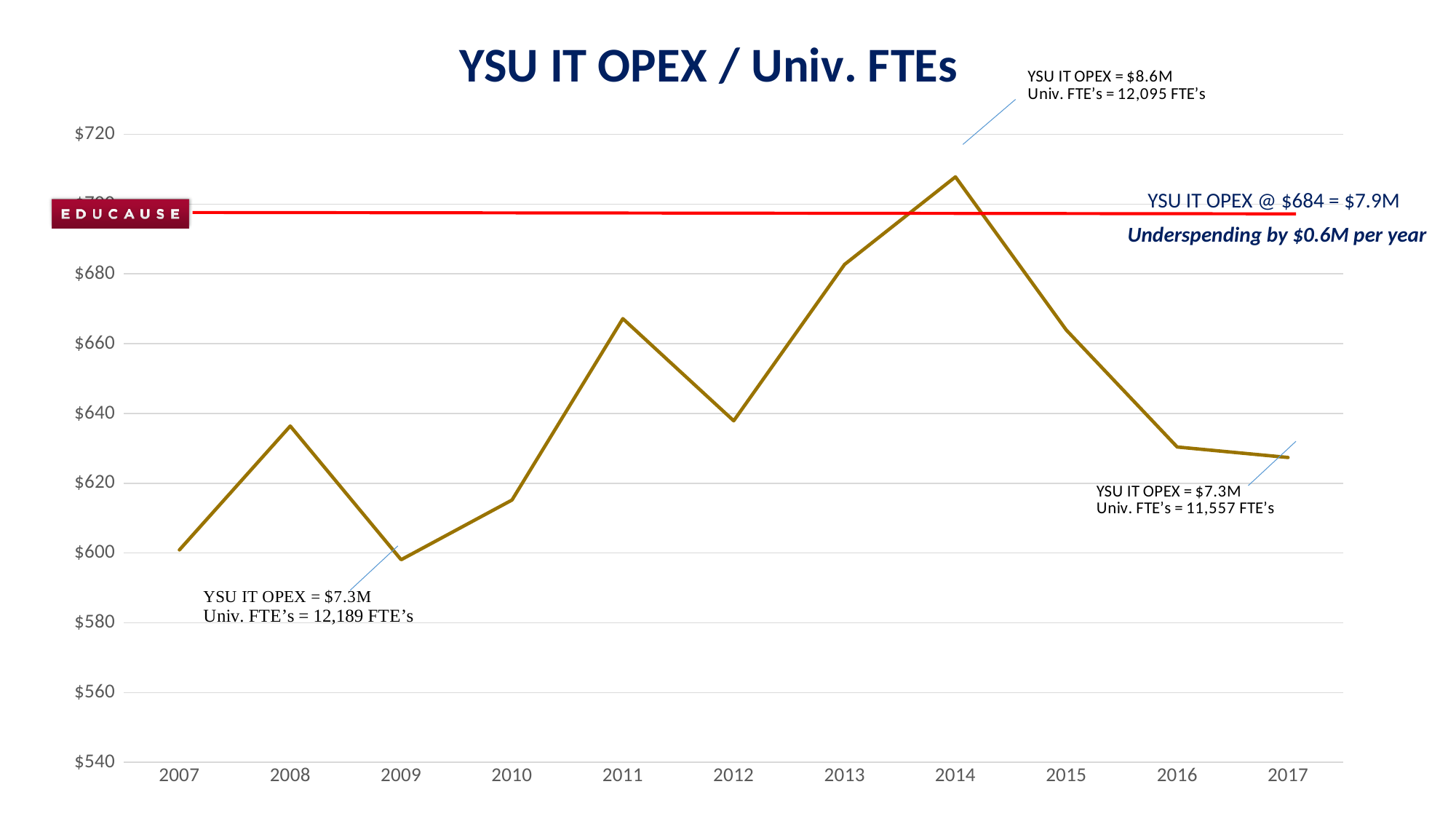
What kind of chart is shown on the slide? line chart At what dollar value is the red horizontal line drawn? $684 Is the value for 2011 greater or less than $660? greater Which year has the highest value on the line? 2014 Which year has the larger value, 2011 or 2012? 2011 Is the value for 2014 greater or less than $700? greater Is the value for 2010 greater or less than $600? greater How many years are plotted along the x axis? 11 Do the values rise or fall from 2014 to 2017? fall What is the title of the chart? YSU IT OPEX / Univ. FTEs Which year has the larger value, 2008 or 2010? 2008